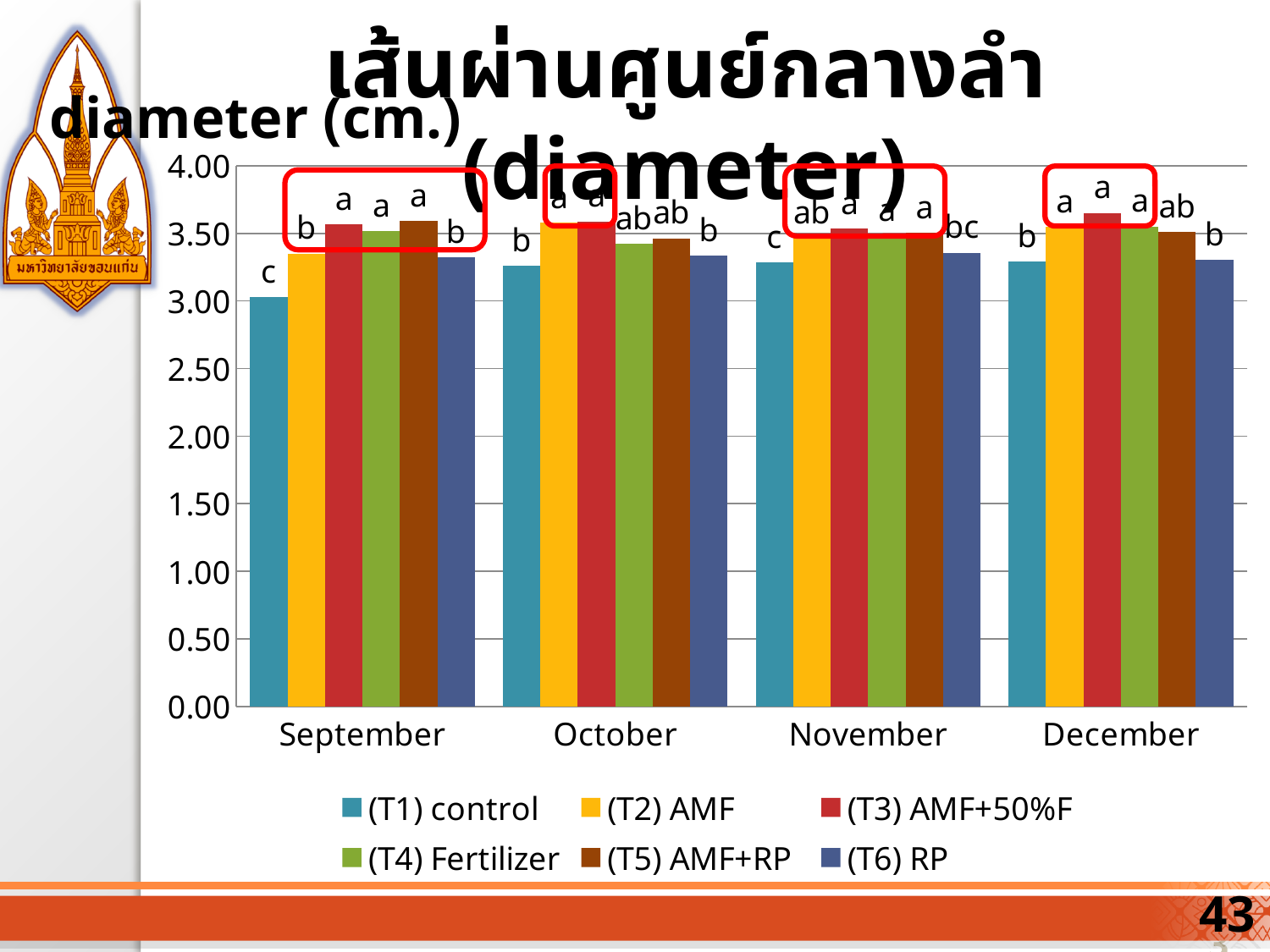
What kind of chart is shown on the slide? bar chart In October, which is larger: the bar for (T2) AMF or the bar for (T6) RP? (T2) AMF Is the value for (T1) control in September greater or less than 3.50? less Does the bar for (T1) control rise or fall from September to October? rise How many series does the chart legend list? 6 What letter is printed above the (T1) control bar in September? c Is the value for (T3) AMF+50%F in December greater or less than 3.50? greater Which treatment has the lowest bar in September? (T1) control Is the value for (T6) RP in October greater or less than 3.50? less How many months are shown on the x axis of the chart? 4 In September, which is larger: the bar for (T1) control or the bar for (T3) AMF+50%F? (T3) AMF+50%F